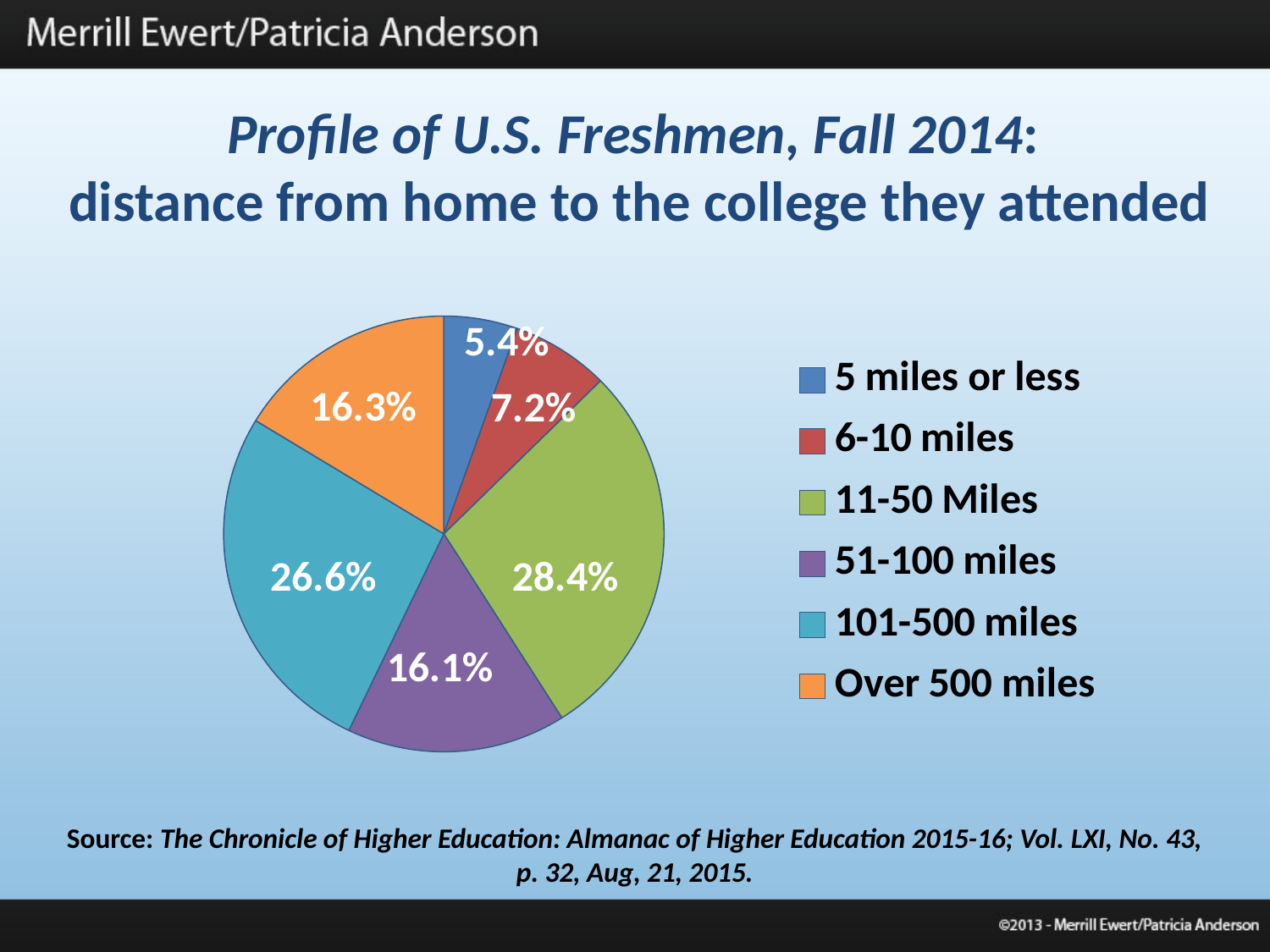
What percentage of freshmen attended a college over 500 miles from home? 16.3% How many distance categories does the pie chart show? 6 Which is larger, the share for 6-10 miles or the share for 51-100 miles? 51-100 miles What percentage of freshmen attended a college 101-500 miles from home? 26.6% Which distance category has the smallest share of the pie? 5 miles or less What is the difference in percentage points between the 6-10 miles slice and the 5 miles or less slice? 1.8 What colour is the slice for 101-500 miles? Teal (light blue) What is the difference in percentage points between the 11-50 Miles slice and the 101-500 miles slice? 1.8 What percentage of freshmen attended a college 11-50 miles from home? 28.4% What type of chart is shown on the slide? Pie chart What percentage of freshmen attended a college 5 miles or less from home? 5.4% Which distance category has the largest share of the pie? 11-50 Miles